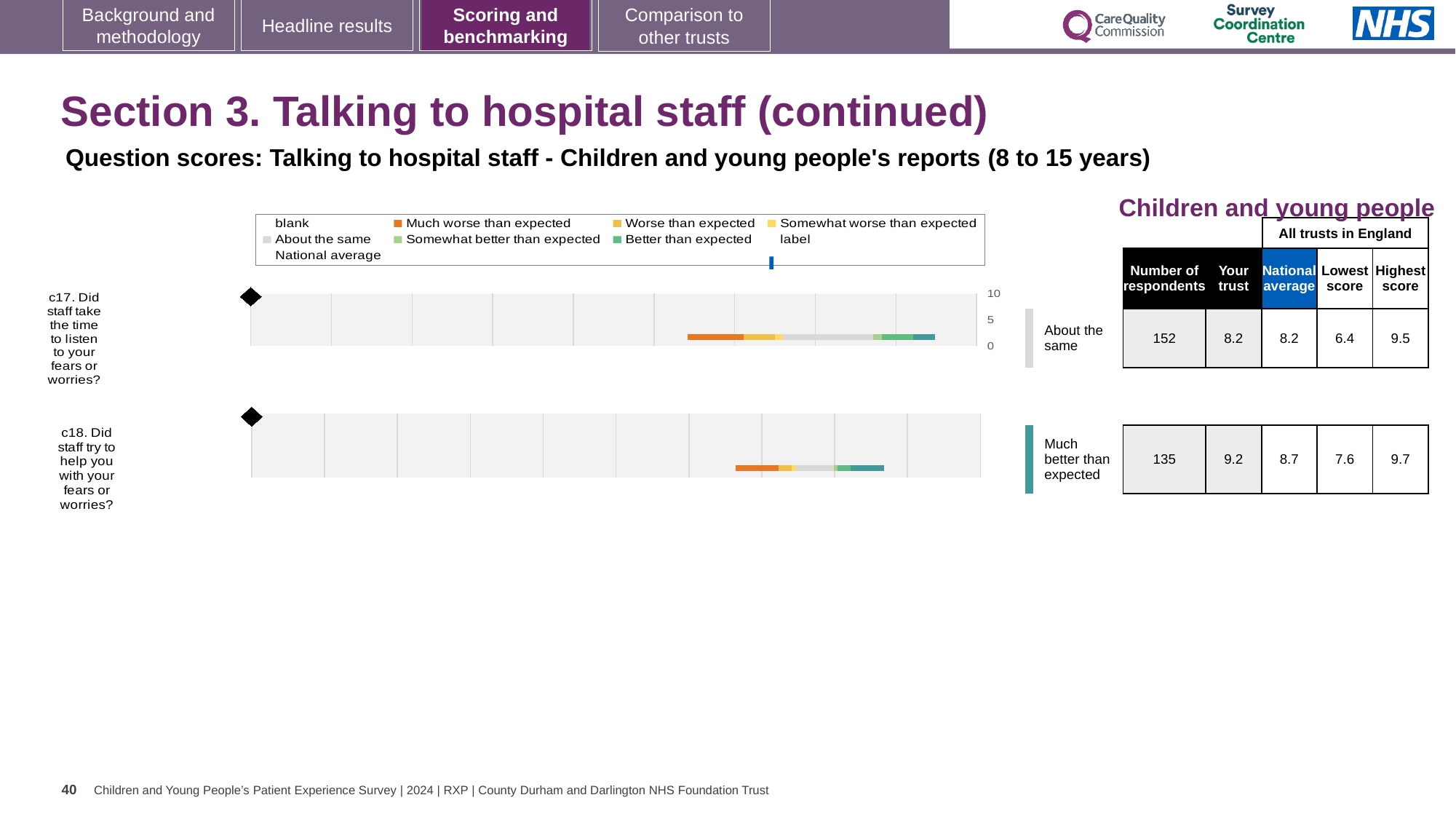
What type of chart is used to show the question scores for c17 and c18? bar chart What is the national average score for c18 (Did staff try to help you with your fears or worries?)? 8.7 How many questions (categories) are plotted on the slide? 2 What benchmark category is shown for c18? Much better than expected What is the difference between the highest and lowest scores across all trusts for c17? 3.1 For c18, is the trust's score higher or lower than the national average? higher What is the 'Your trust' score for c17 (Did staff take the time to listen to your fears or worries?)? 8.2 How many respondents answered c17? 152 What is the difference between the trust's score and the national average for c18? 0.5 Which question has the higher 'Your trust' score, c17 or c18? c18 What is the highest score across all trusts in England for c18? 9.7 What is the lowest score across all trusts in England for c17? 6.4